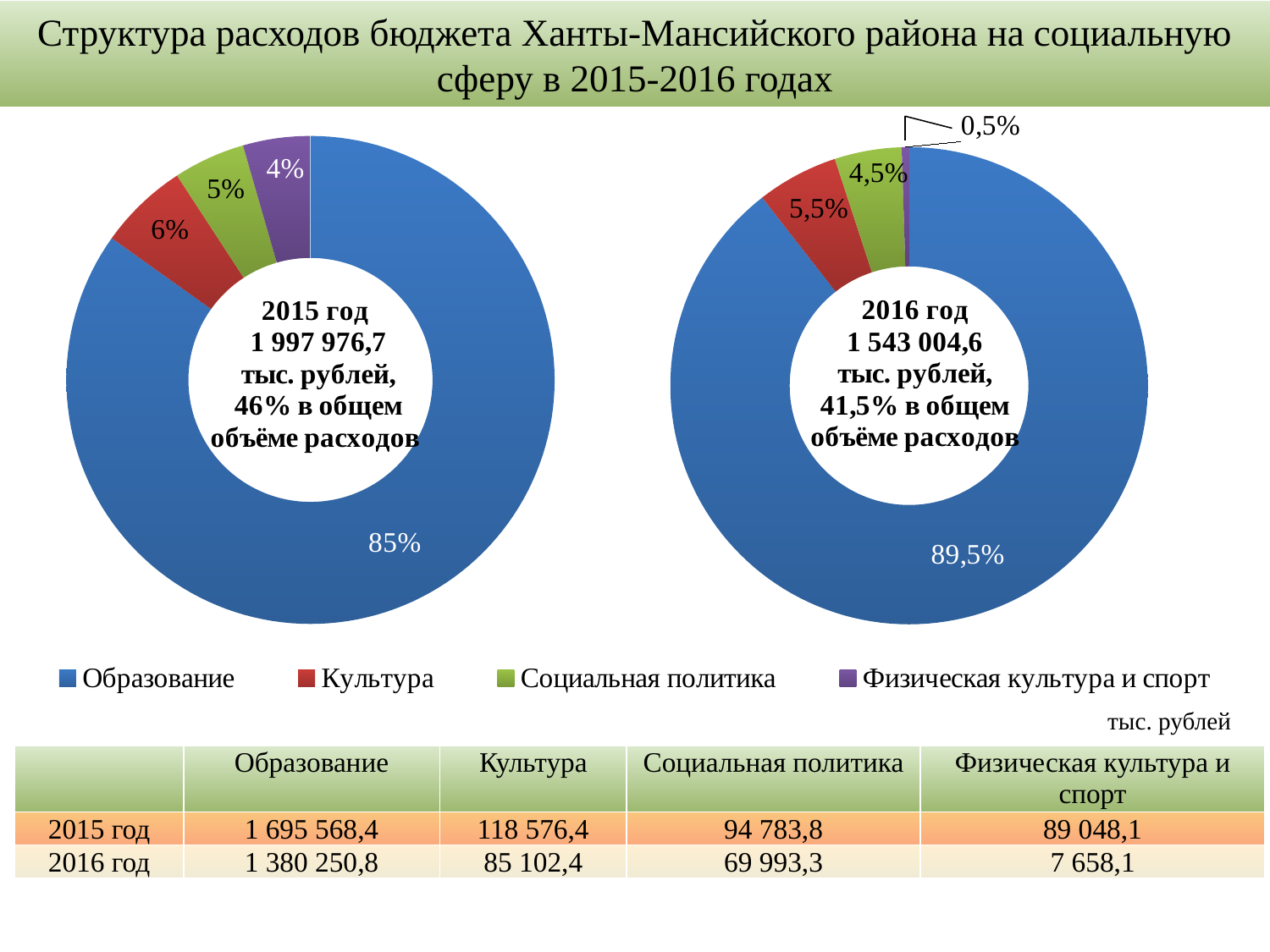
On the 2015 год chart, what is the difference between the shares of Культура and Социальная политика? 1% On the 2015 год chart, what share does Образование have? 85% What kind of chart is the 2015 год chart? Doughnut chart On the 2016 год chart, what share does Физическая культура и спорт have? 0,5% What colour represents Социальная политика in the legend? Green On the 2016 год chart, which is larger: the share of Культура or the share of Социальная политика? Культура How many categories does the legend list? 4 On the 2015 год chart, what share does Культура have? 6% On the 2016 год chart, what share does Социальная политика have? 4,5% On the 2016 год chart, what share does Образование have? 89,5% On the 2016 год chart, which category has the largest share? Образование On the 2015 год chart, which category has the smallest share? Физическая культура и спорт